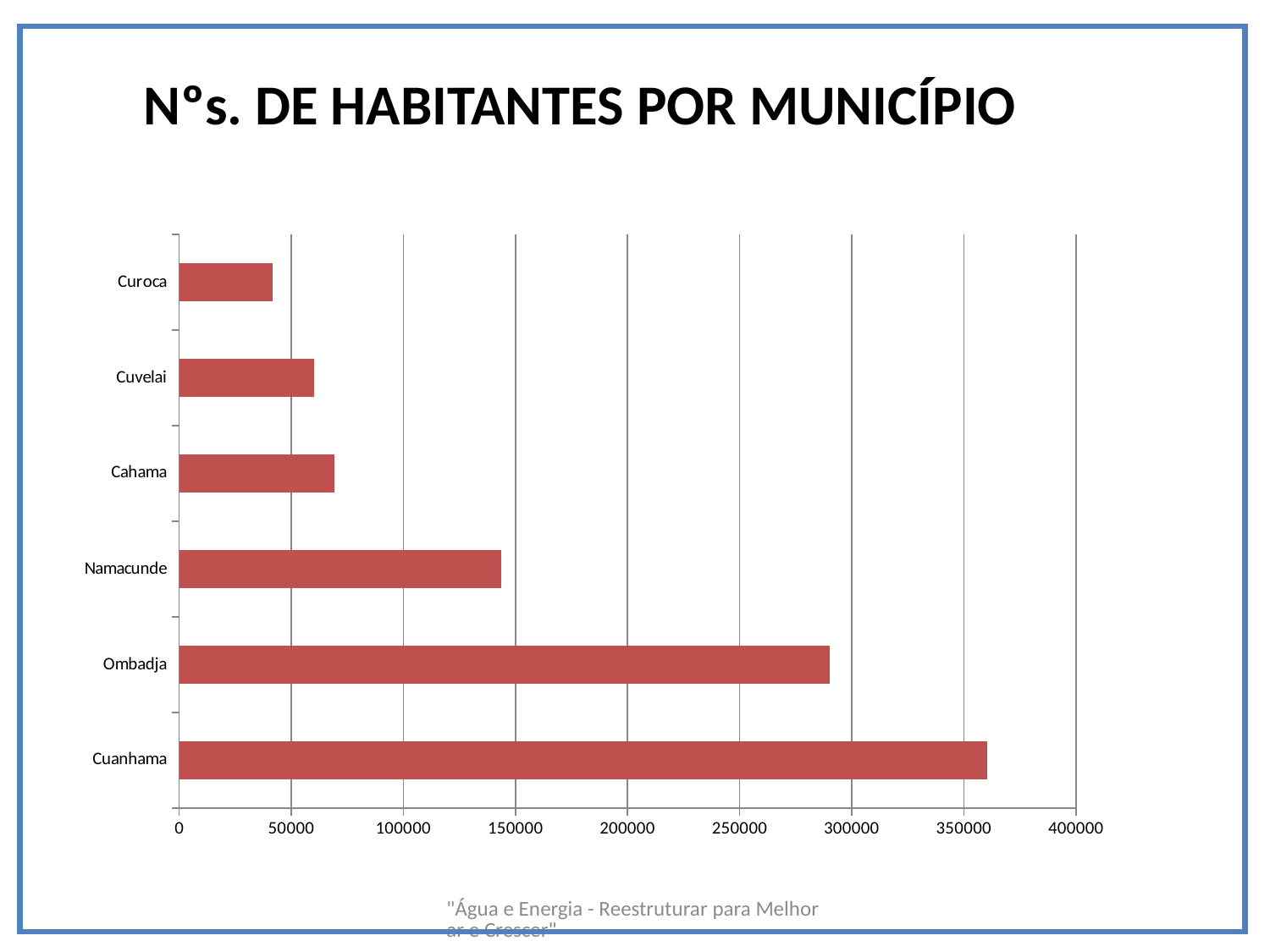
Is the value for Cahama greater or less than 50000? greater Which has more inhabitants, Cuvelai or Curoca? Cuvelai Is the value for Curoca greater or less than 50000? less How many municipalities are shown in the chart? 6 Is the value for Ombadja greater or less than 300000? less Which municipality has the lowest number of inhabitants? Curoca What kind of chart is shown on the slide? bar chart Which municipality has the highest number of inhabitants? Cuanhama Which has more inhabitants, Ombadja or Namacunde? Ombadja What is the title of the chart? Nºs. DE HABITANTES POR MUNICÍPIO